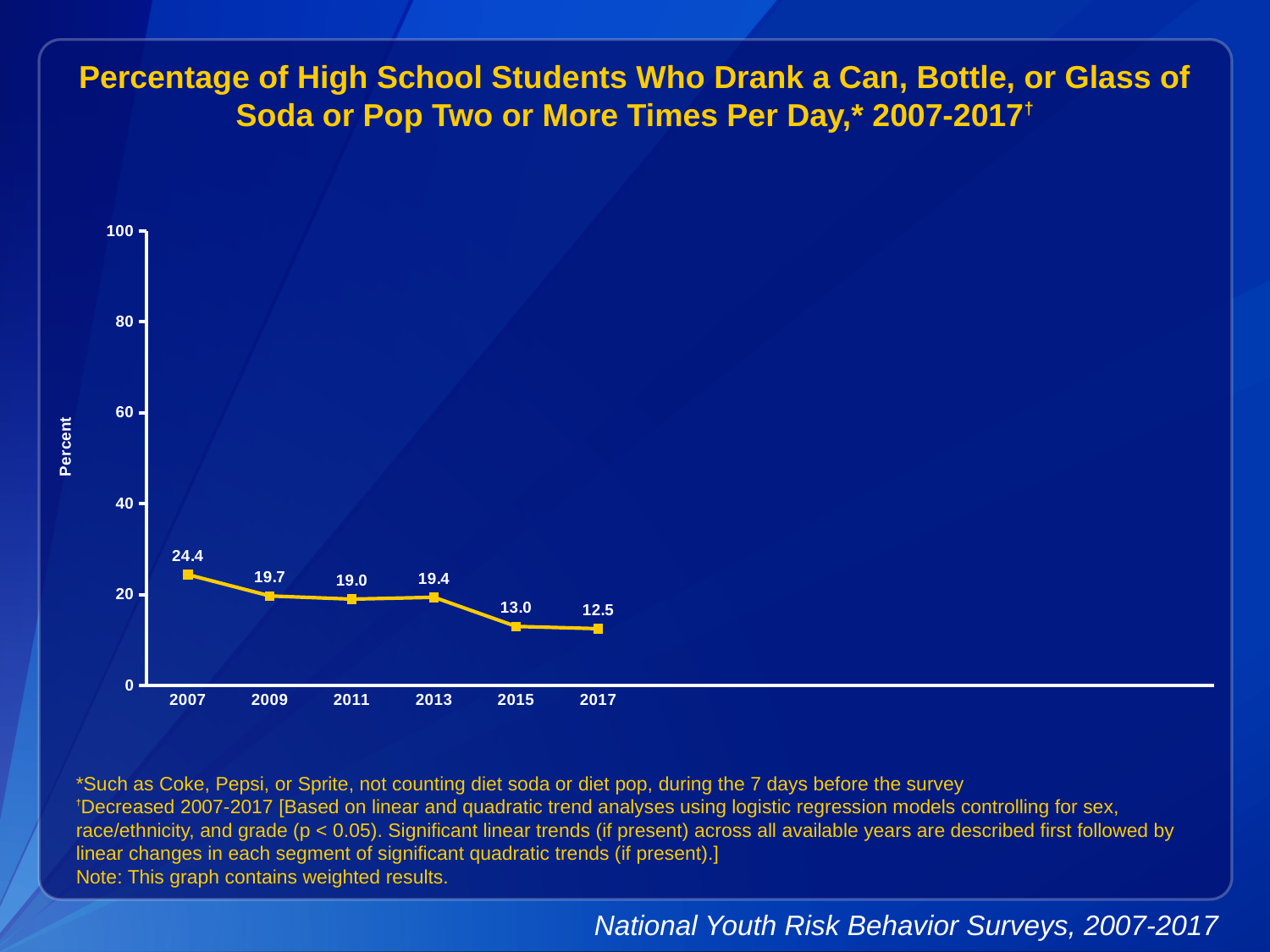
Which year has the highest percentage? 2007 How many years are plotted on the chart? 6 By how many percentage points did the value fall from 2007 to 2017? 11.9 What kind of chart is shown on the slide? line chart What percentage of high school students drank soda or pop two or more times per day in 2007? 24.4 Is the value for 2007 greater or less than 20? greater What is the label on the vertical axis? Percent What is the value plotted for 2013? 19.4 Which year has the lowest percentage? 2017 Which year has the larger value, 2011 or 2013? 2013 What is the value plotted for 2017? 12.5 What is the difference between the 2013 and 2015 values? 6.4